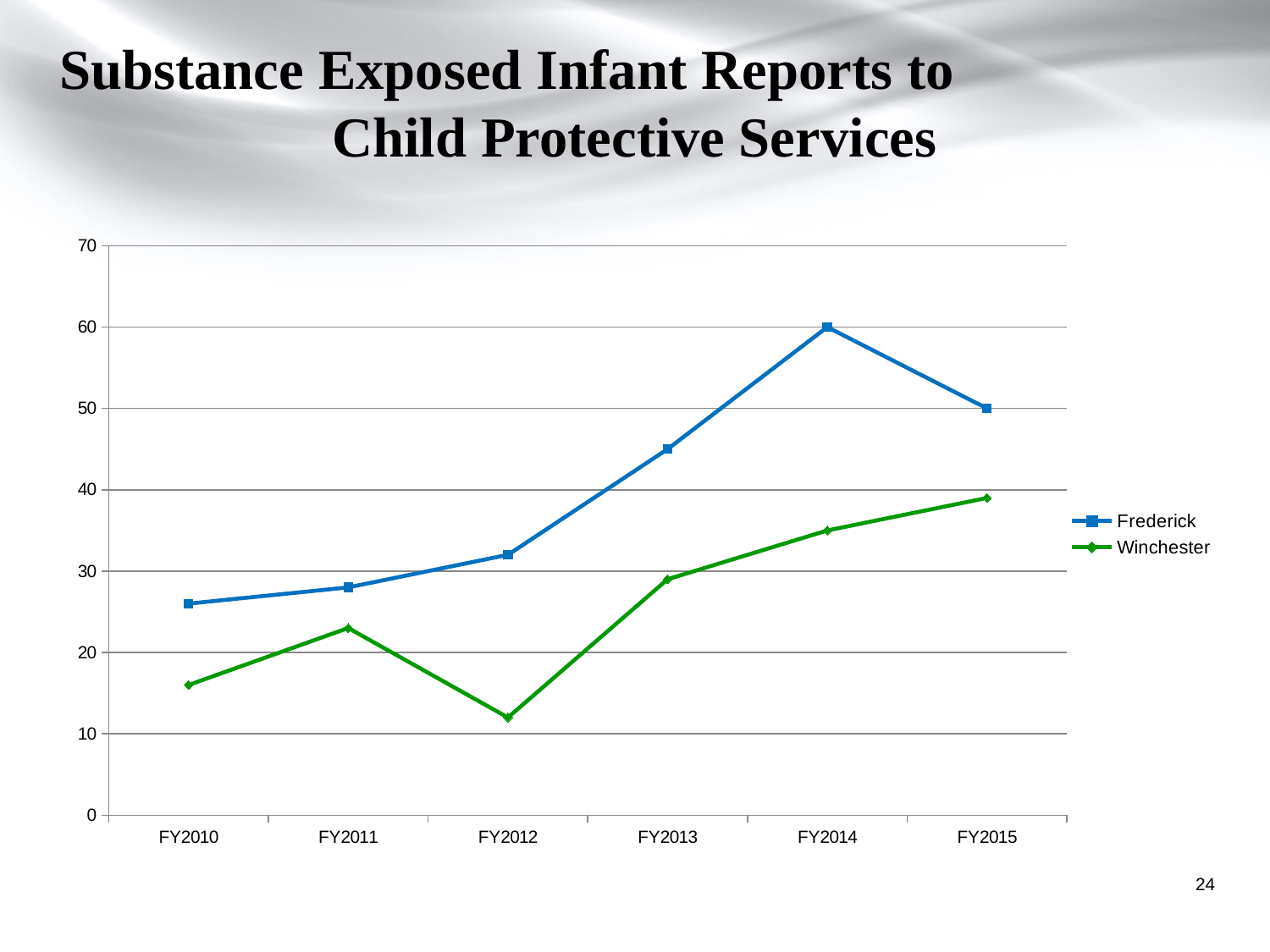
Is the value for Winchester in FY2012 greater or less than 20? less In which fiscal year is the Frederick value highest? FY2014 What is the value for Frederick in FY2014? 60 Which series has the larger value in FY2013, Frederick or Winchester? Frederick Is the value for Frederick in FY2013 greater or less than 40? greater How many series does the legend list? 2 What is the value for Frederick in FY2015? 50 By how much did the Frederick value fall from FY2014 to FY2015? 10 What kind of chart is shown on the slide? line chart In which fiscal year is the Winchester value lowest? FY2012 Does the Winchester line rise or fall from FY2012 to FY2015? rise How many fiscal years are plotted along the x axis? 6